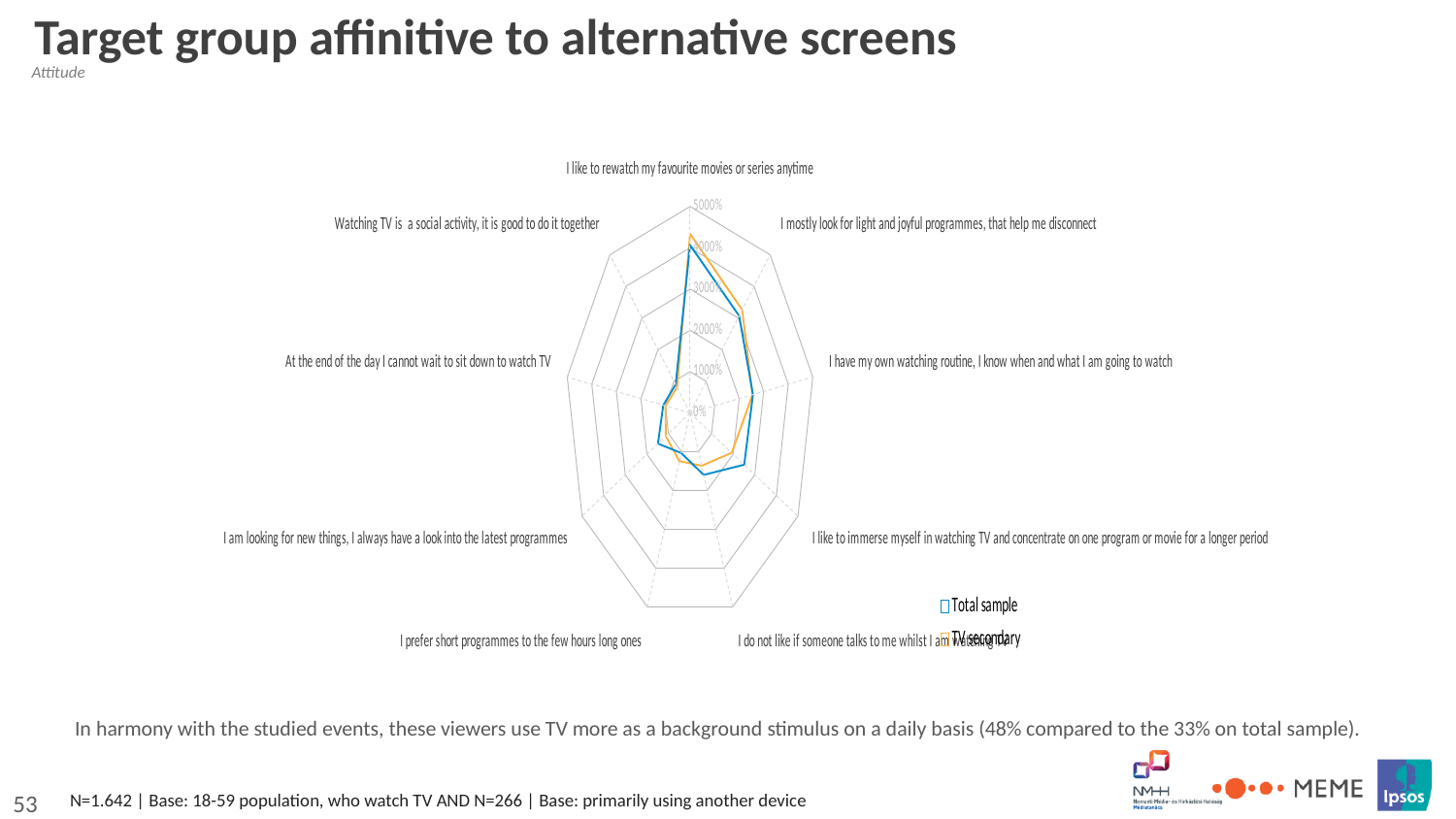
How many attitude statements (categories) are plotted on the radar chart? 9 Is the Total sample value for 'I do not like if someone talks to me whilst I am watching TV' greater or less than 3000%? less What is the highest value shown on the radar chart's axis scale? 5000% What is the title of the slide containing the radar chart? Target group affinitive to alternative screens What kind of chart is shown on the slide? Radar chart Is the Total sample value for 'I have my own watching routine, I know when and what I am going to watch' greater or less than 1000%? greater Is the TV secondary value for 'At the end of the day I cannot wait to sit down to watch TV' greater or less than 3000%? less How many series does the legend list? 2 What are the two series named in the legend? Total sample and TV secondary Which statement has the highest value for the Total sample series? I like to rewatch my favourite movies or series anytime